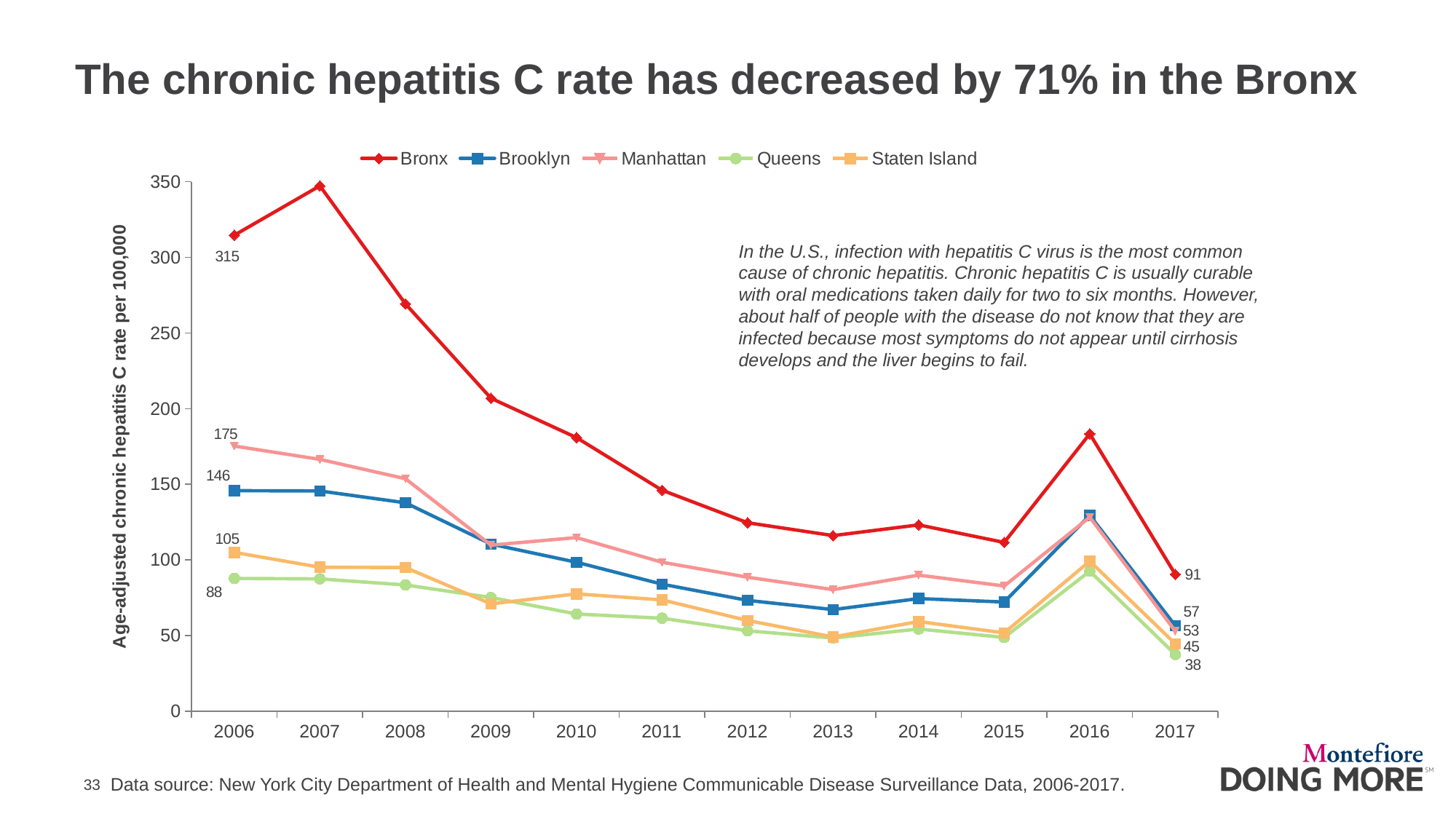
What was the Bronx chronic hepatitis C rate in 2017? 91 By how much did the Bronx rate fall between 2006 and 2017? 224 How many boroughs are listed in the legend? 5 In 2006, which had the higher rate, Brooklyn or Staten Island? Brooklyn What was the Manhattan rate in 2006? 175 How many years are shown on the x axis? 12 Which borough had the highest rate in 2006? Bronx What was the Queens rate in 2006? 88 Is the Bronx rate in 2007 greater or less than 300? greater What was the Bronx chronic hepatitis C rate in 2006? 315 What kind of chart is shown on the slide? Line chart Which borough had the lowest rate in 2017? Queens